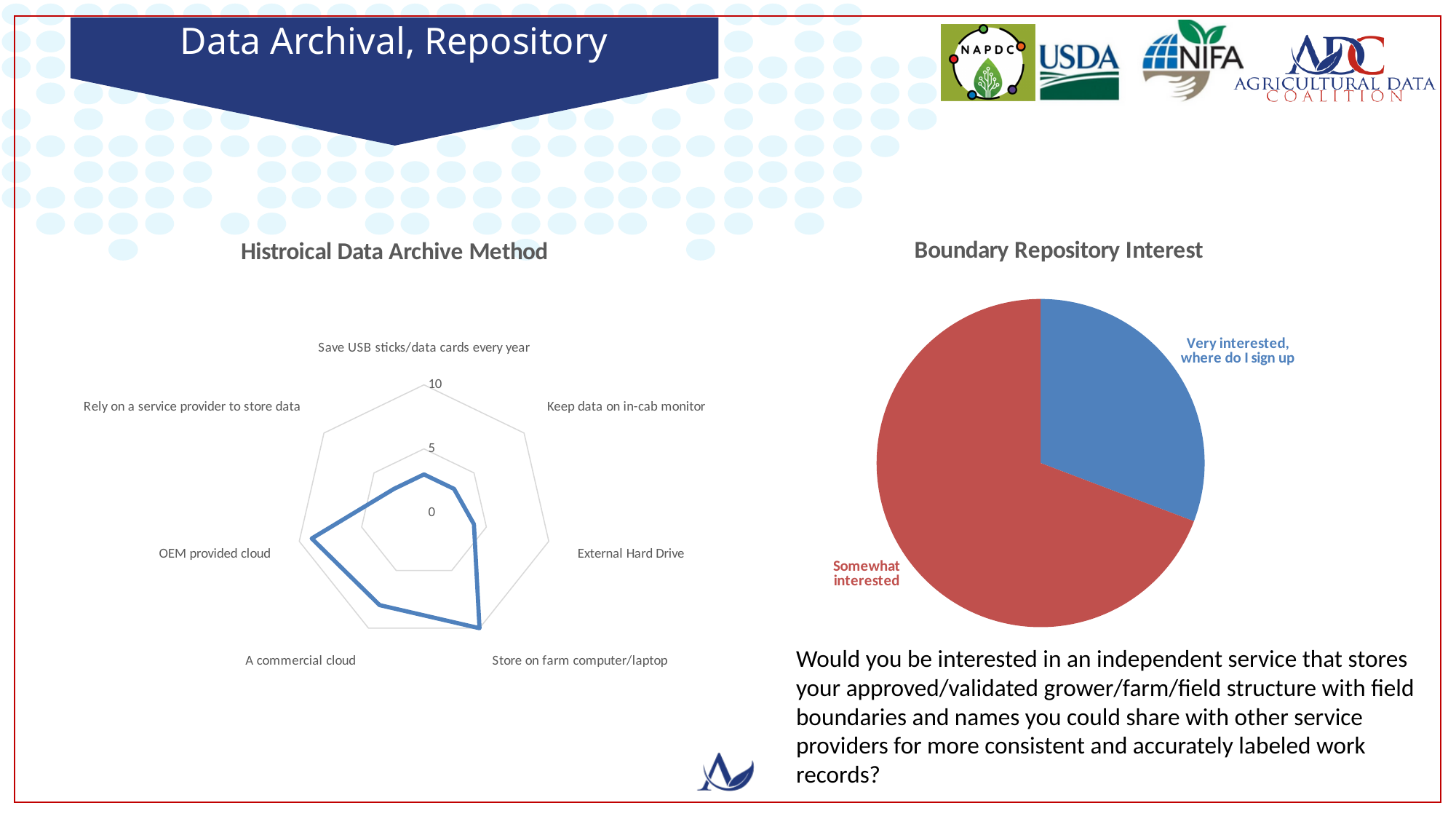
In the "Boundary Repository Interest" pie chart, what colour is the "Somewhat interested" slice? Red In the "Histroical Data Archive Method" chart, which has the larger value: "OEM provided cloud" or "Keep data on in-cab monitor"? OEM provided cloud In the "Histroical Data Archive Method" chart, is the value for "Save USB sticks/data cards every year" greater or less than 5? less In the "Histroical Data Archive Method" chart, which has the larger value: "A commercial cloud" or "External Hard Drive"? A commercial cloud In the "Histroical Data Archive Method" chart, is the value for "Rely on a service provider to store data" greater or less than 5? less In the "Histroical Data Archive Method" chart, is the value for "Store on farm computer/laptop" greater or less than 5? greater What kind of chart is the "Boundary Repository Interest" chart on the right? Pie chart What kind of chart is the "Histroical Data Archive Method" chart on the left? Radar chart How many slices does the "Boundary Repository Interest" pie chart have? 2 How many archive methods are plotted on the "Histroical Data Archive Method" radar chart? 7 In the "Boundary Repository Interest" pie chart, which slice is larger: "Very interested, where do I sign up" or "Somewhat interested"? Somewhat interested